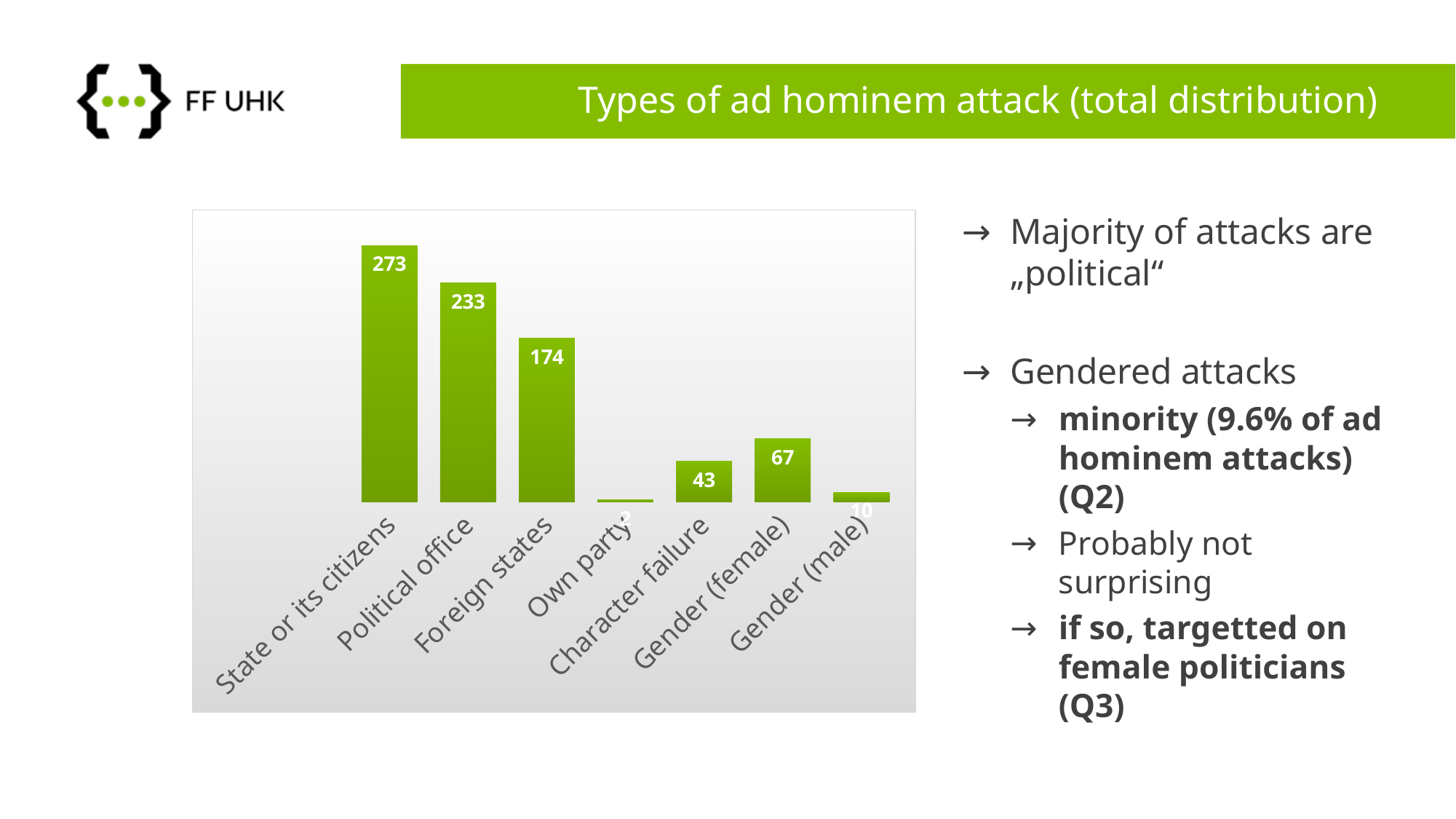
How many categories are shown in the chart? 7 What is the title of the slide containing the chart? Types of ad hominem attack (total distribution) What is the value for Foreign states? 174 What is the difference between the values for State or its citizens and Political office? 40 What type of chart is shown on the slide? bar chart What is the value for Political office? 233 What is the value for State or its citizens? 273 Which is larger, the value for Gender (female) or the value for Character failure? Gender (female) What is the value for Character failure? 43 What is the value for Gender (female)? 67 Which category has the lowest value? Own party Which category has the highest value? State or its citizens